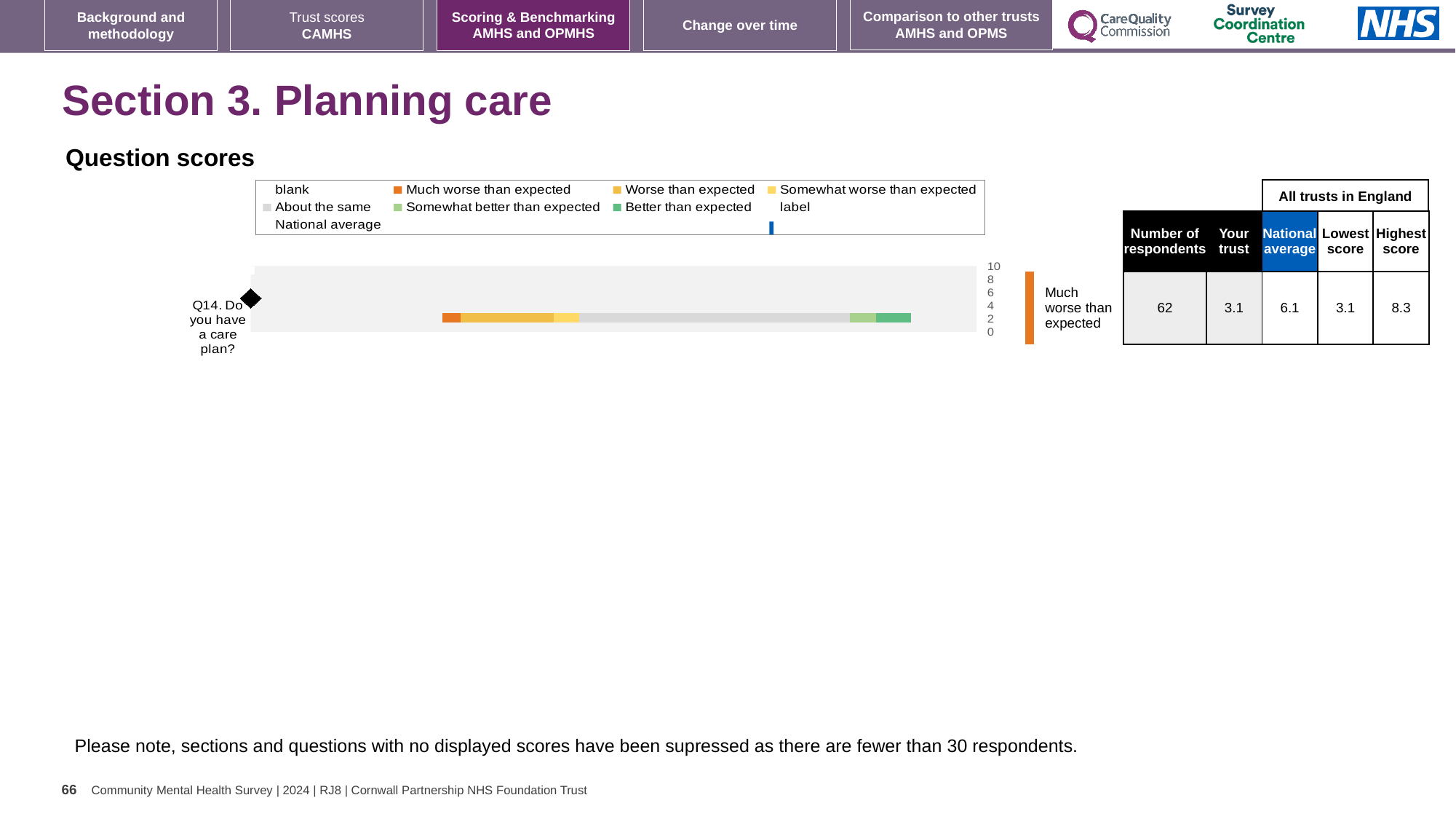
What is the lowest score among all trusts in England for Q14? 3.1 How many respondents answered Q14? 62 What is the national average score for Q14? 6.1 Which benchmark category is the trust's Q14 score placed in, according to the label beside the chart? Much worse than expected What is the highest score among all trusts in England for Q14? 8.3 What kind of chart is used to show the question scores for Q14? bar chart Which question is plotted in the Question scores chart? Q14. Do you have a care plan? What is the difference between the national average and the trust's score for Q14? 3.0 Which is larger for Q14, the trust's score or the national average? national average How many questions are plotted in the Question scores chart? 1 What is the difference between the highest and lowest scores for Q14? 5.2 What is the 'Your trust' score for Q14 shown in the table? 3.1